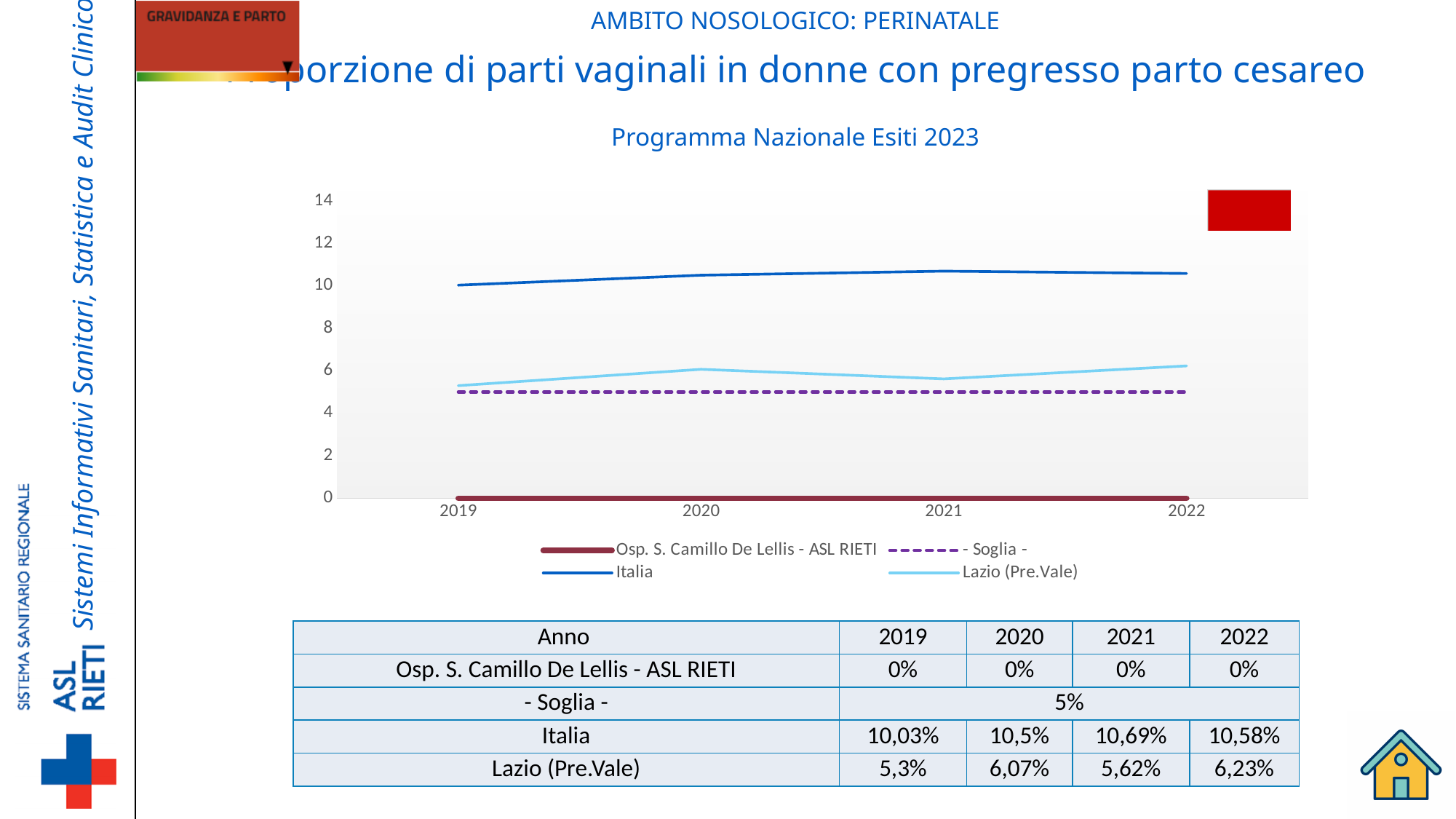
What is the value for Italia in 2021? 10,69% Which is larger in 2020, the value for Italia or the value for Lazio (Pre.Vale)? Italia What is the difference between the Italia and Lazio (Pre.Vale) values in 2019? 4,73% What is the value for Osp. S. Camillo De Lellis - ASL RIETI in 2020? 0% How many series does the chart legend list? 4 Is the value for Italia in 2022 greater or less than 10? greater What kind of chart is shown on the slide? line chart In which year is the Lazio (Pre.Vale) series lowest? 2019 What is the value for Lazio (Pre.Vale) in 2022? 6,23% How many years are shown on the x axis of the chart? 4 In which year is the Italia series highest? 2021 What is the value of the Soglia (threshold) line? 5%